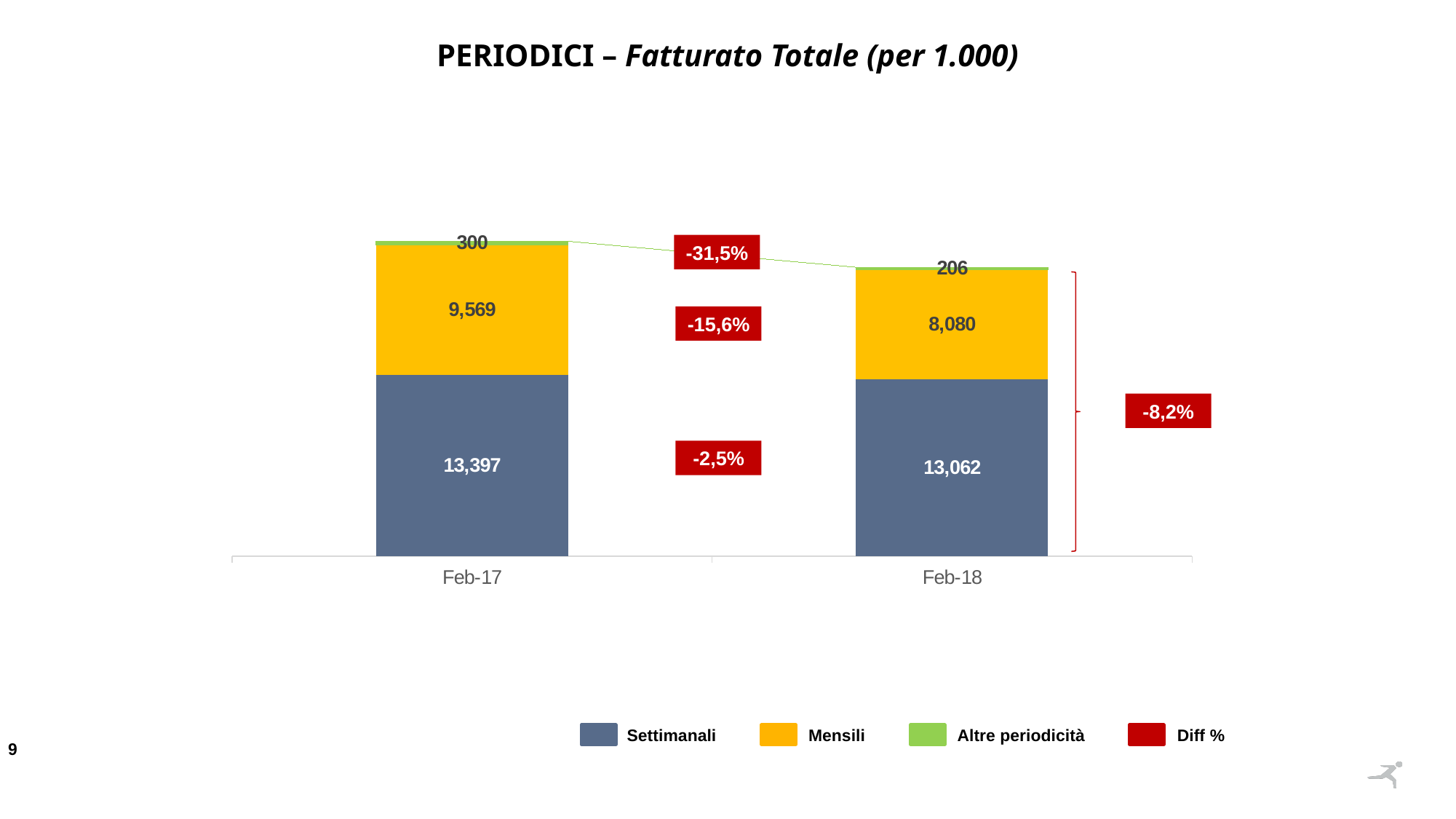
Which series has the largest value in Feb-18? Settimanali What is the total of the stacked bar for Feb-18? 21,348 What is the Diff % shown for the Mensili series between Feb-17 and Feb-18? -15,6% What is the difference between the Mensili values for Feb-17 and Feb-18? 1,489 What is the Settimanali value for Feb-17? 13,397 How many categories are shown on the x axis? 2 Which series has the smallest value in Feb-17? Altre periodicità What is the Mensili value for Feb-18? 8,080 What is the overall Diff % shown for the total between Feb-17 and Feb-18? -8,2% What kind of chart is shown on the slide? Stacked bar chart What is the Altre periodicità value for Feb-17? 300 Is the Settimanali value larger in Feb-17 or Feb-18? Feb-17